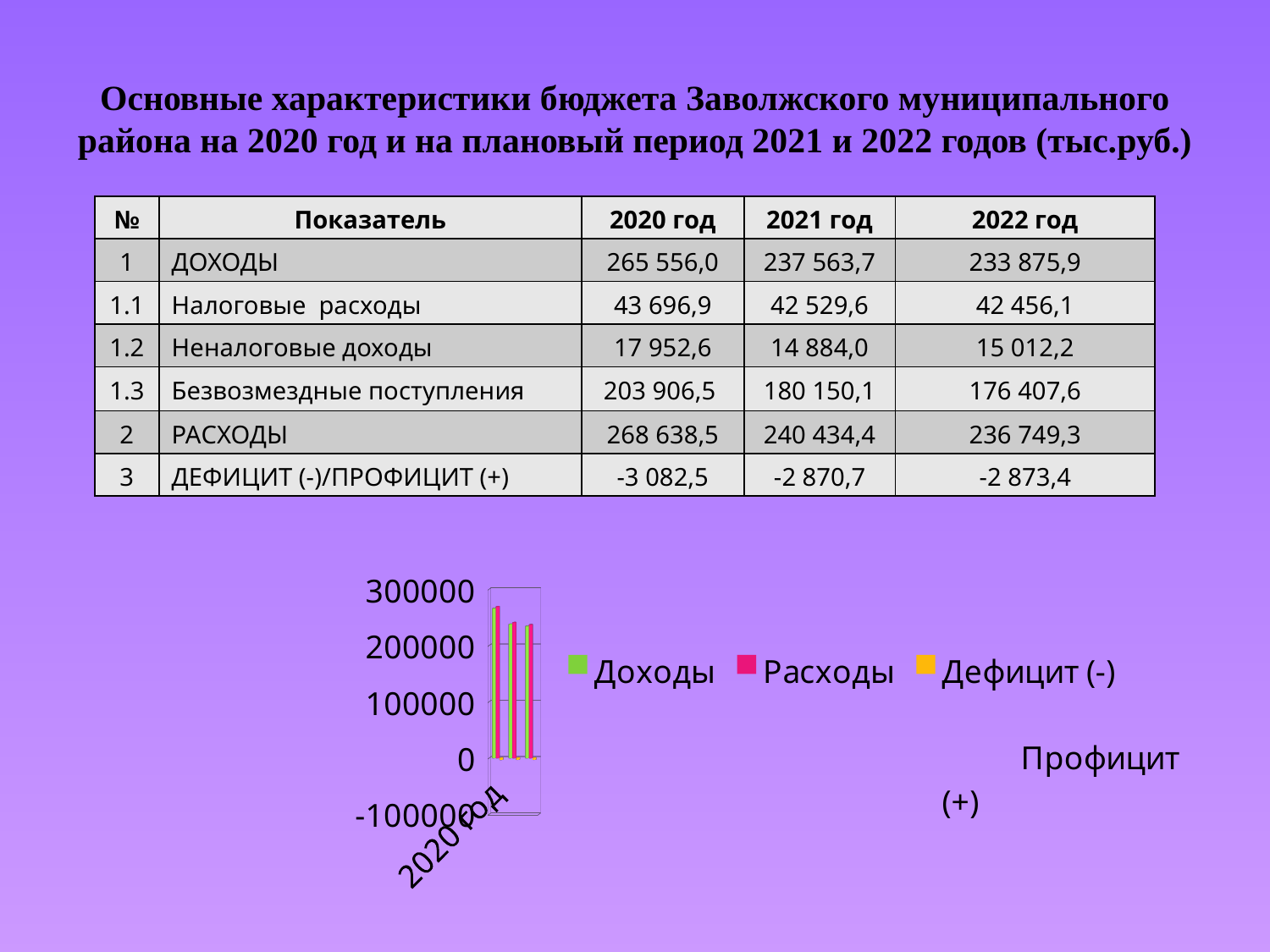
Is the value for Расходы in 2020 год greater or less than 300000? less What kind of chart is shown at the bottom of the slide? bar chart Is the value for Доходы in 2020 год greater or less than 100000? greater Is the value for Доходы in 2020 год greater or less than 200000? greater Which series is shown in pink in the chart's legend? Расходы Which series is shown in green in the chart's legend? Доходы How many series does the chart's legend list? 3 Do the Доходы bars rise or fall from left to right along the x axis? fall What is the highest tick value shown on the chart's vertical axis? 300000